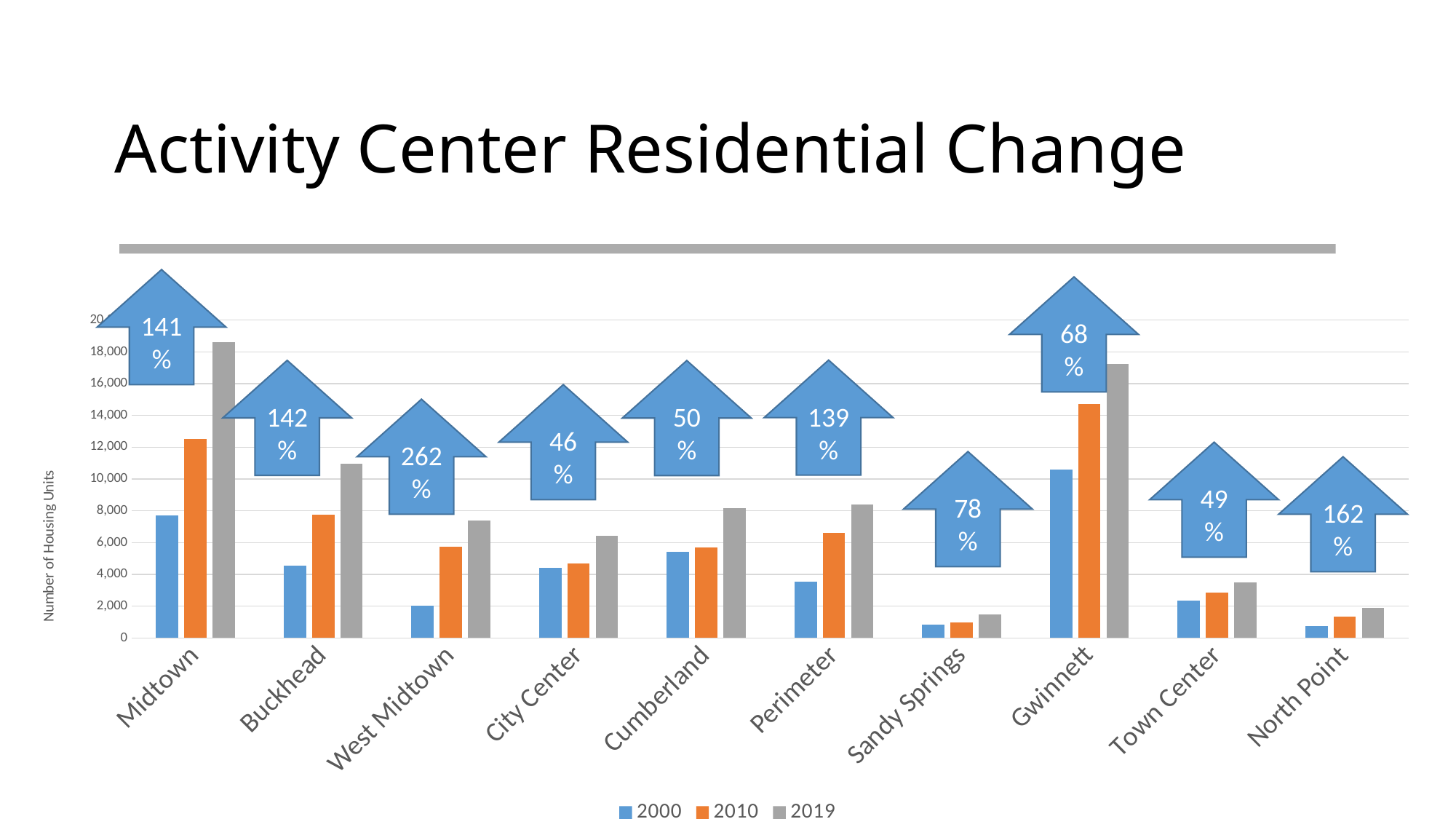
How many series does the chart's legend list? 3 What is the label on the chart's vertical axis? Number of Housing Units Which activity center has the highest 2000 value? Gwinnett Is the 2000 value for Gwinnett greater or less than 8,000? greater What kind of chart is shown on the slide? bar chart Which is larger, the 2010 value for Gwinnett or the 2010 value for Buckhead? Gwinnett Which activity center has the highest 2019 value? Midtown What percentage change is shown in the arrow above West Midtown? 262% Is the 2019 value for Midtown greater or less than 16,000? greater How many activity centers are shown on the x axis of the chart? 10 Do the values for Midtown rise or fall from 2000 to 2019? rise Is the 2019 value for Sandy Springs greater or less than 2,000? less